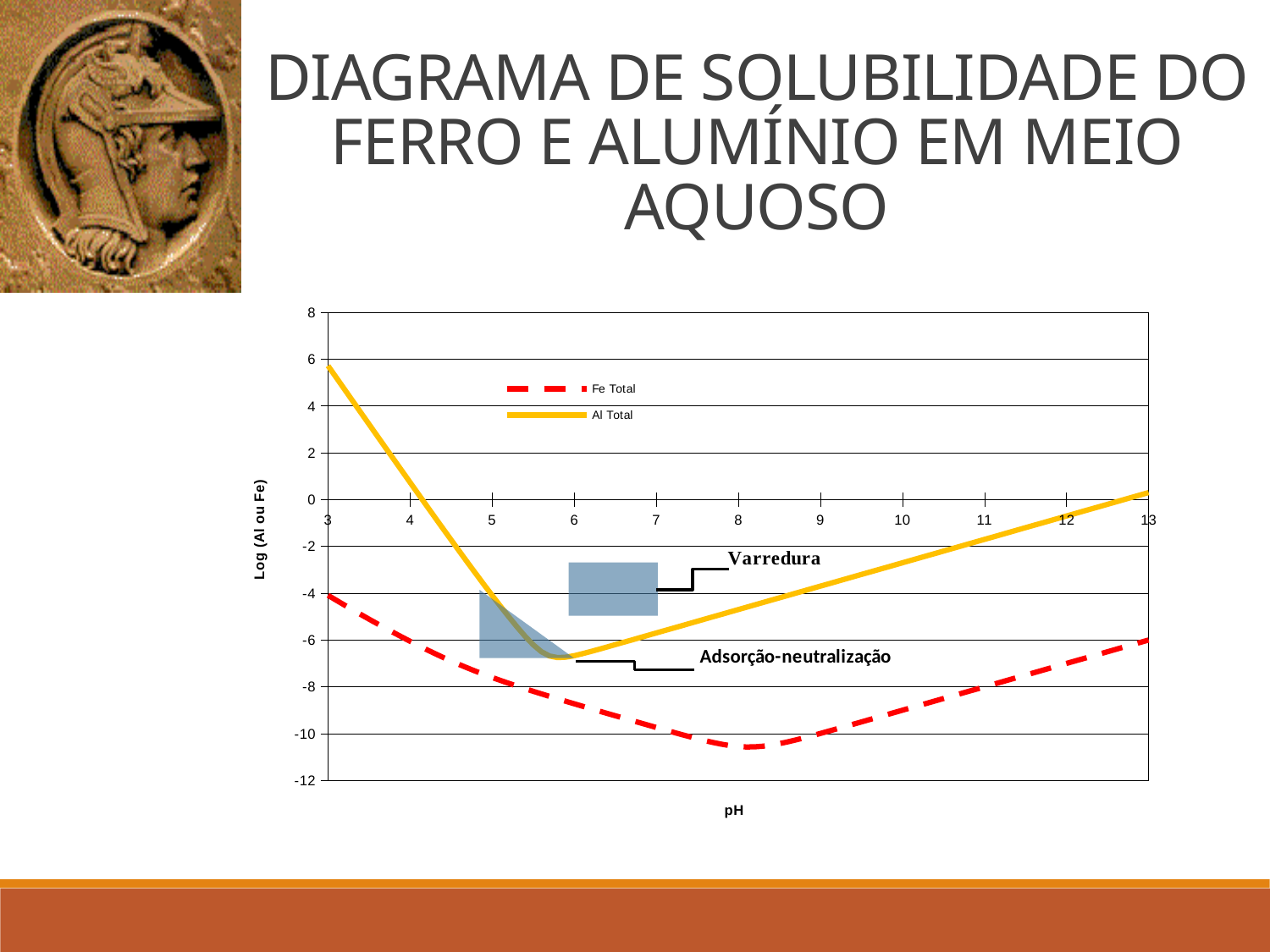
Is the value of Al Total at pH 4 greater or less than 0? greater How many series does the chart legend list? 2 What is the label of the x axis? pH What are the two series named in the legend? Fe Total and Al Total Does the Al Total line rise or fall as pH increases from 6 to 13? Rises At pH 8, which series has the higher value, Fe Total or Al Total? Al Total Is the value of Al Total at pH 3 greater or less than 4? greater Is the value of Fe Total at pH 8 greater or less than -10? less Does the Fe Total line rise or fall as pH increases from 3 to 8? Falls What kind of chart is shown on the slide? Line chart